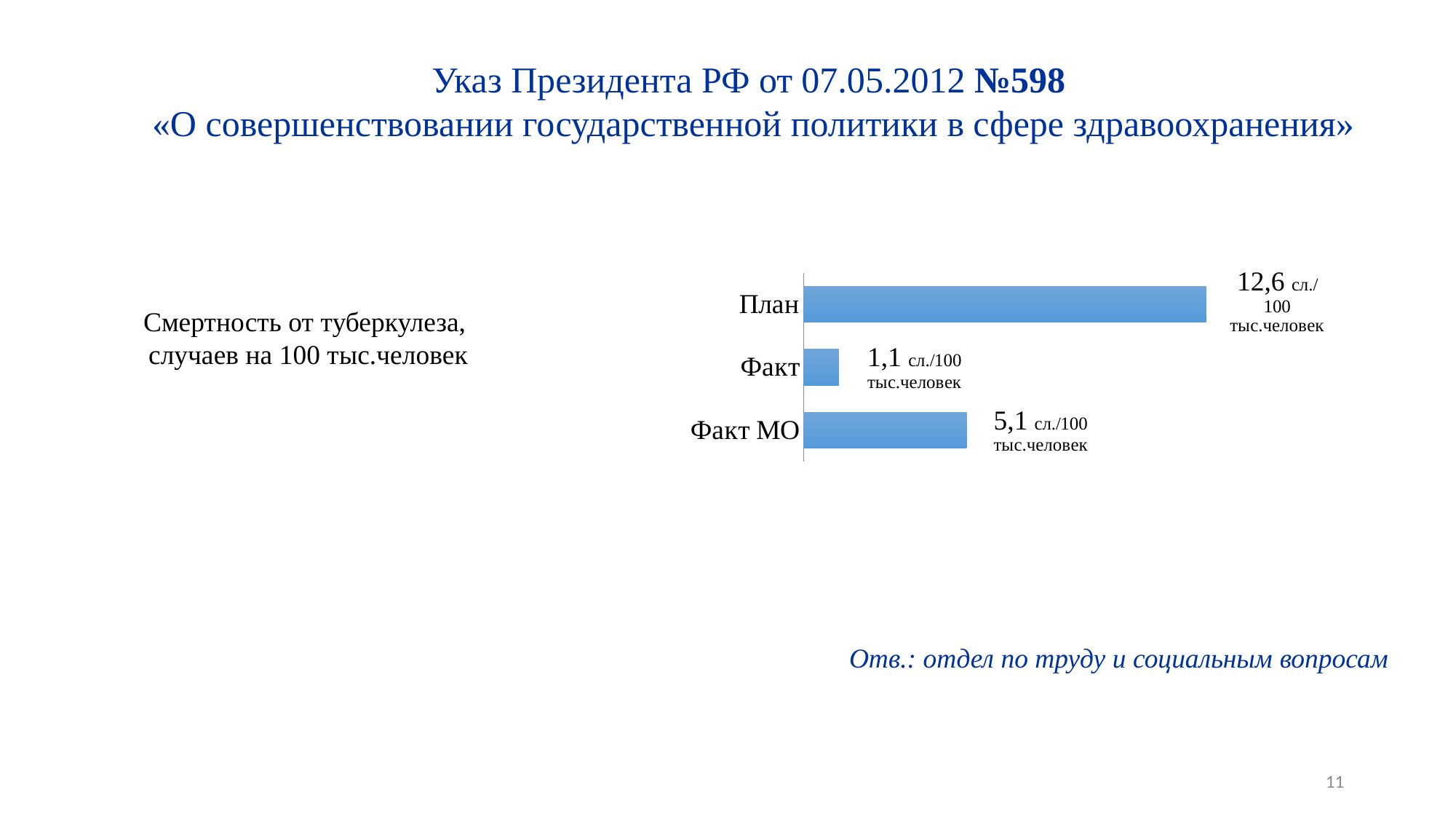
What indicator does the chart show, according to the text to its left? Смертность от туберкулеза, случаев на 100 тыс.человек What kind of chart is shown on the slide? Bar chart How many categories (bars) are shown in the chart? 3 Which is larger, the value for Факт МО or the value for Факт? Факт МО What is the value for План (Plan) in the tuberculosis mortality chart? 12,6 What is the difference between the Факт МО value and the Факт value? 4,0 What unit is given in the data labels of the chart? сл./100 тыс.человек Which category has the lowest value in the chart? Факт What is the difference between the План value and the Факт value? 11,5 What is the value for Факт (Fact) in the tuberculosis mortality chart? 1,1 Which category has the highest value in the chart? План What is the value for Факт МО in the tuberculosis mortality chart? 5,1